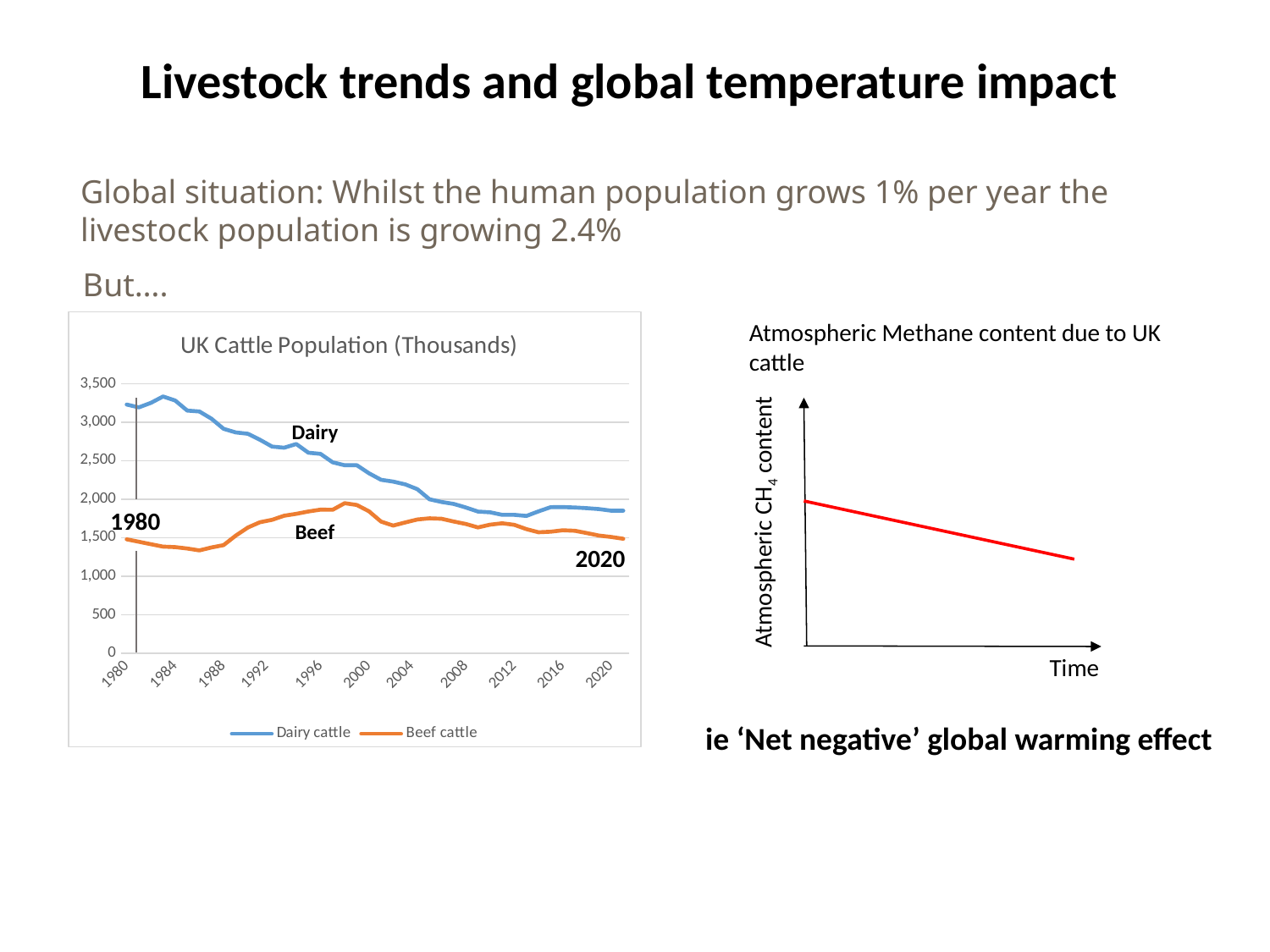
What kind of chart is the UK Cattle Population (Thousands) chart? line chart In the UK Cattle Population (Thousands) chart, is the Beef cattle value in 1988 greater or less than 1,500? less In the UK Cattle Population (Thousands) chart, is the Dairy cattle value in 2000 greater or less than 2,000? greater How many series does the legend of the UK Cattle Population (Thousands) chart list? 2 How many year labels are shown on the x axis of the UK Cattle Population (Thousands) chart? 11 In the UK Cattle Population (Thousands) chart, is the Dairy cattle value in 2020 greater or less than 1,500? greater In the chart on the right titled Atmospheric Methane content due to UK cattle, does the red line rise or fall over Time? fall In the UK Cattle Population (Thousands) chart, which series is higher in 2020, Dairy cattle or Beef cattle? Dairy cattle What are the two legend entries of the UK Cattle Population (Thousands) chart? Dairy cattle, Beef cattle In the UK Cattle Population (Thousands) chart, which series is higher in 1980, Dairy cattle or Beef cattle? Dairy cattle In the UK Cattle Population (Thousands) chart, does the Dairy cattle series rise or fall from 1980 to 2020? fall